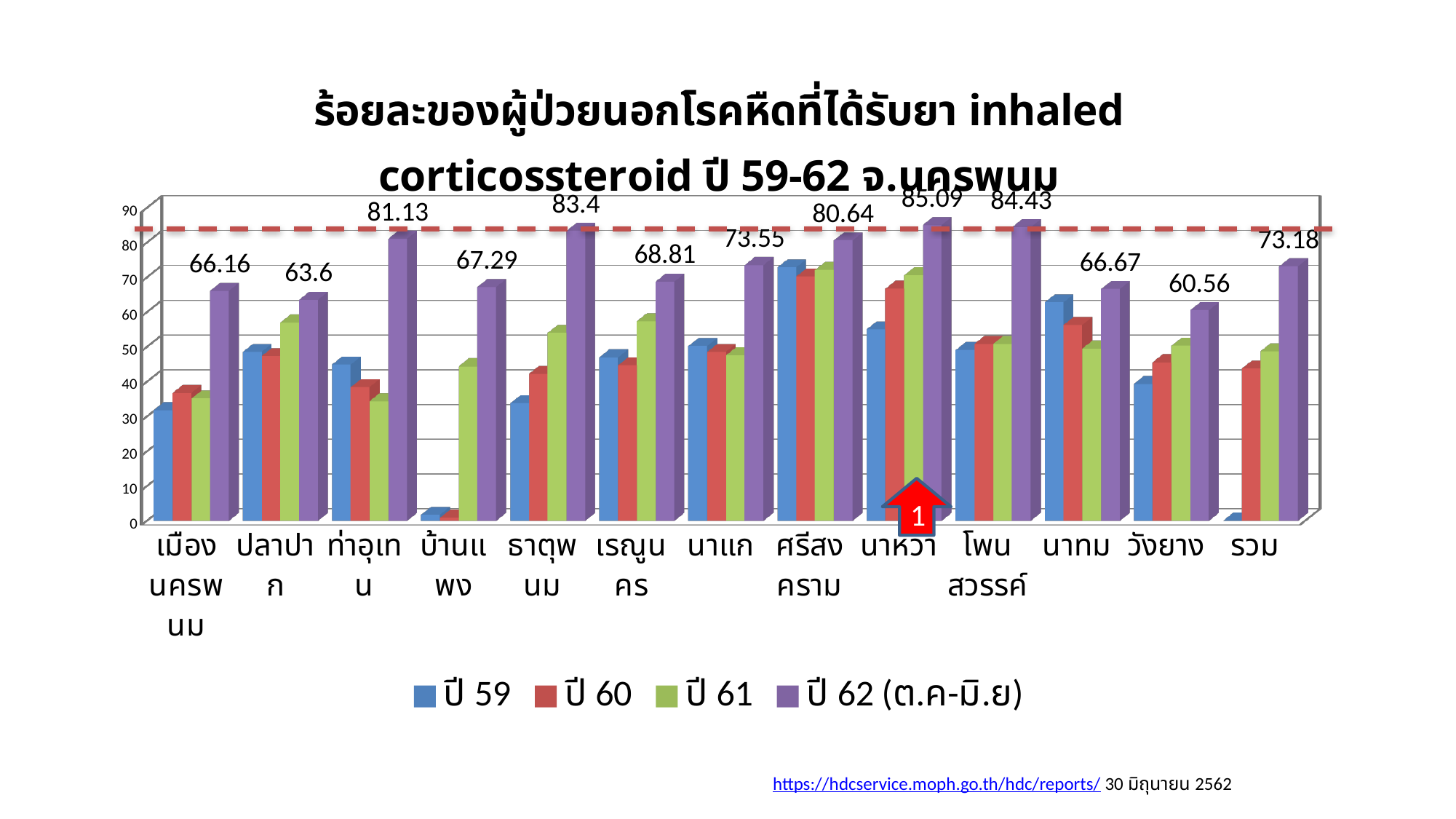
Is the ปี 59 value for บ้านแพง greater or less than 10? less What is the ปี 62 (ต.ค-มิ.ย) value for รวม? 73.18 Which category has the lowest ปี 62 (ต.ค-มิ.ย) value? วังยาง Which category has the highest ปี 62 (ต.ค-มิ.ย) value? นาหว้า How many series does the legend list? 4 What kind of chart is shown on the slide? bar chart What is the difference between the ปี 62 (ต.ค-มิ.ย) values for นาหว้า and โพนสวรรค์? 0.66 Which has the larger ปี 62 (ต.ค-มิ.ย) value, ธาตุพนม or ศรีสงคราม? ธาตุพนม How many categories are shown on the x axis? 13 What is the difference between the ปี 62 (ต.ค-มิ.ย) values for ท่าอุเทน and ปลาปาก? 17.53 What is the ปี 62 (ต.ค-มิ.ย) value for นาหว้า? 85.09 What is the ปี 62 (ต.ค-มิ.ย) value for ท่าอุเทน? 81.13